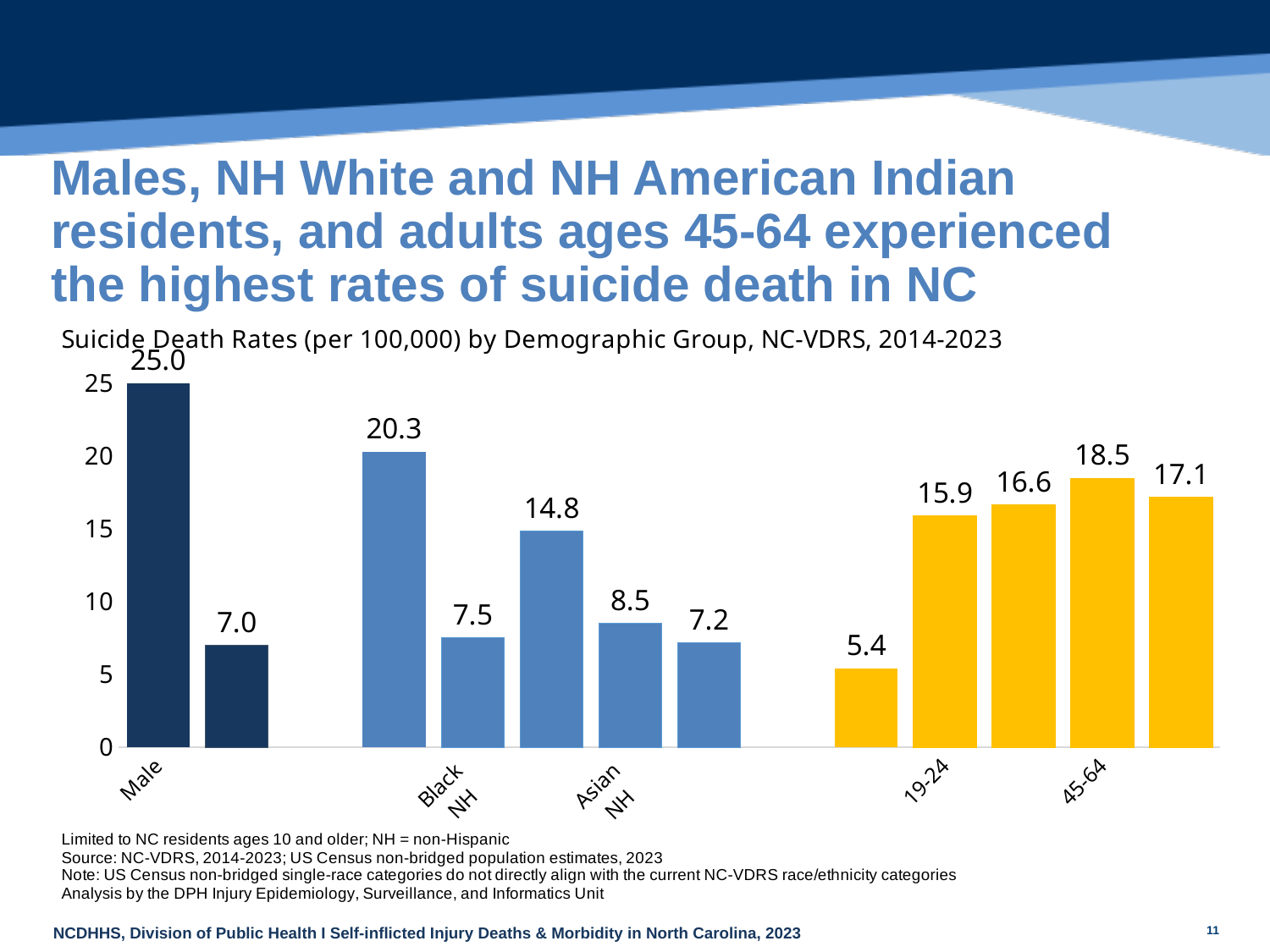
What is the difference between the suicide death rates for ages 45-64 and ages 19-24? 2.6 What is the difference between the suicide death rates for Asian NH and Black NH? 1.0 What is the suicide death rate for ages 45-64? 18.5 Which has a higher suicide death rate, Male or ages 45-64? Male What is the suicide death rate for Asian NH? 8.5 What is the suicide death rate for ages 19-24? 15.9 What is the suicide death rate for Black NH? 7.5 How many bars are plotted on the chart? 12 Is the suicide death rate for Black NH greater or less than 10? less What is the suicide death rate for Male? 25.0 What kind of chart is shown on the slide? bar chart Which demographic group has the highest suicide death rate on the chart? Male